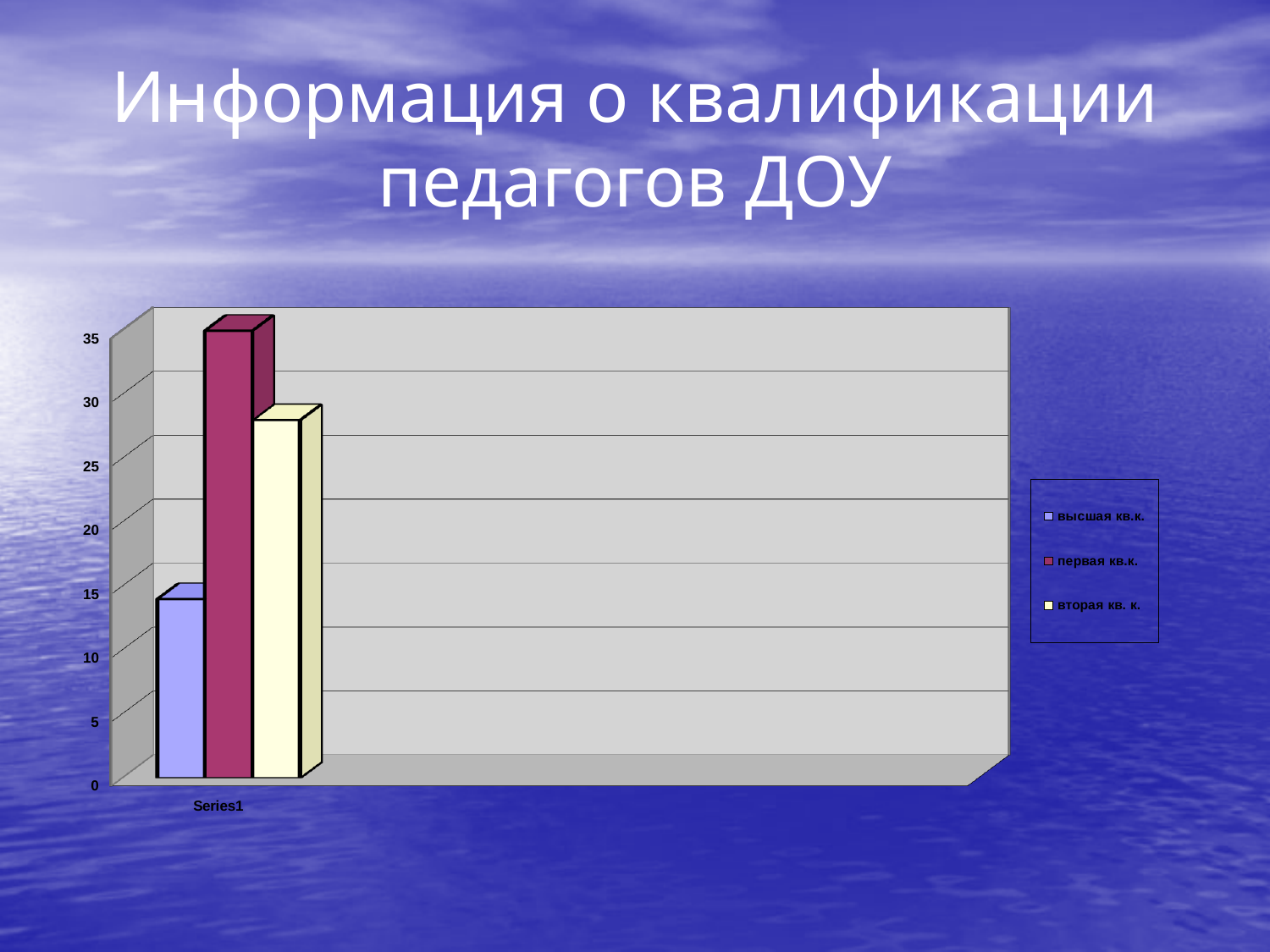
Which is larger, the bar for высшая кв.к. or the bar for вторая кв. к.? вторая кв. к. Is the value for первая кв.к. greater or less than 30? greater How many series does the legend list? 3 How many categories are shown on the x axis? 1 Which series has the highest bar? первая кв.к. Is the value for вторая кв. к. greater or less than 25? greater Is the value for высшая кв.к. greater or less than 10? greater What kind of chart is shown on the slide? bar chart Which series has the lowest bar? высшая кв.к. Which is larger, the bar for первая кв.к. or the bar for вторая кв. к.? первая кв.к. What is the title of the slide containing the chart? Информация о квалификации педагогов ДОУ